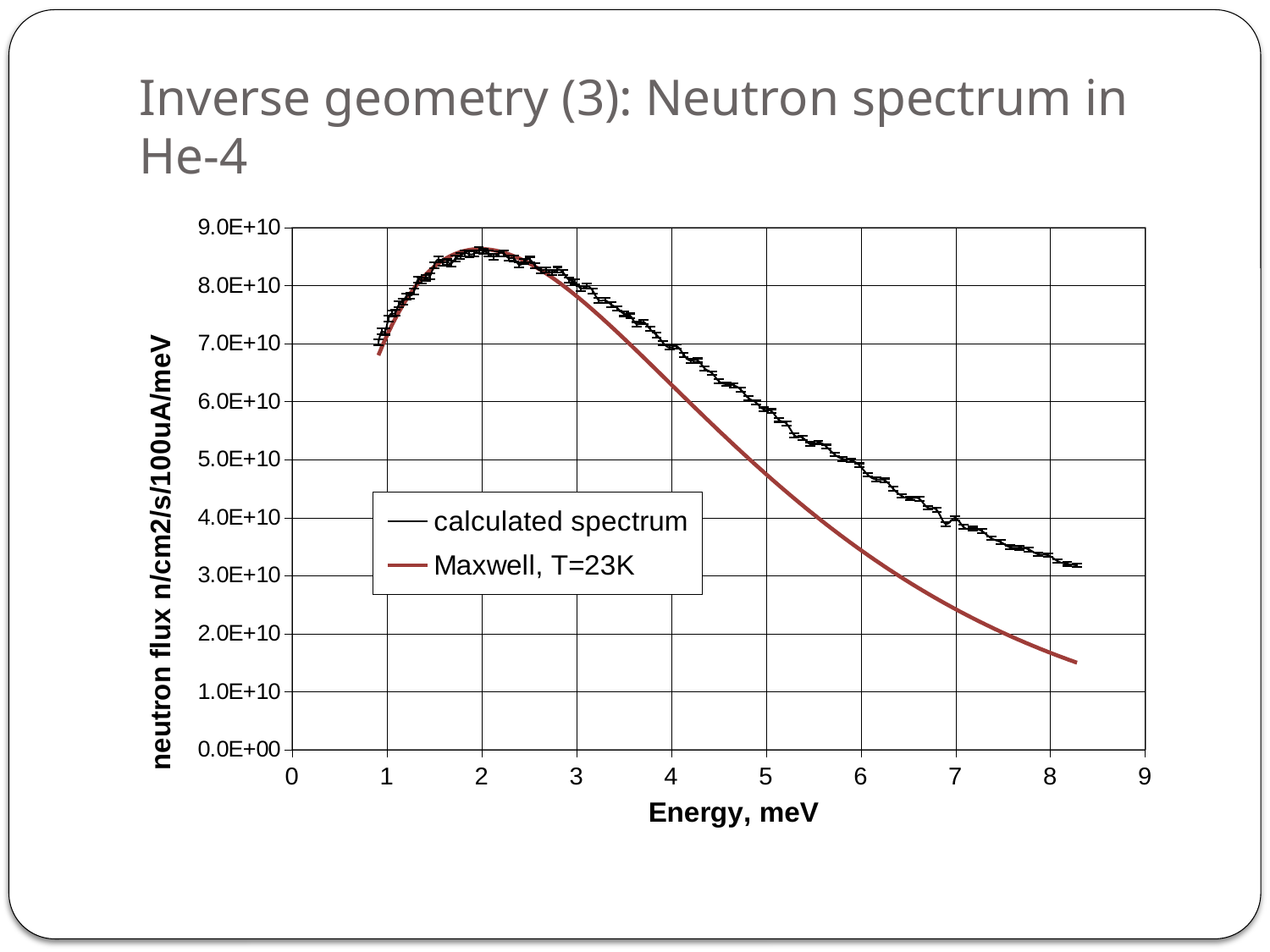
Is the value of the Maxwell, T=23K curve at 8 meV greater or less than 2.0E+10? less Between 3 meV and 8 meV, do the values of the calculated spectrum rise or fall as energy increases? fall How many series does the legend list? 2 Is the peak value of the calculated spectrum greater or less than 8.0E+10? greater What are the two series named in the legend? calculated spectrum; Maxwell, T=23K What kind of chart is shown on the slide? line chart At 6 meV, which series has the higher neutron flux, the calculated spectrum or the Maxwell, T=23K curve? calculated spectrum At 8 meV, which series has the lower neutron flux, the calculated spectrum or the Maxwell, T=23K curve? Maxwell, T=23K Between 1 meV and 2 meV, do the values of the Maxwell, T=23K curve rise or fall as energy increases? rise What is the x-axis title of the chart? Energy, meV Is the value of the Maxwell, T=23K curve at 5 meV greater or less than 5.0E+10? less